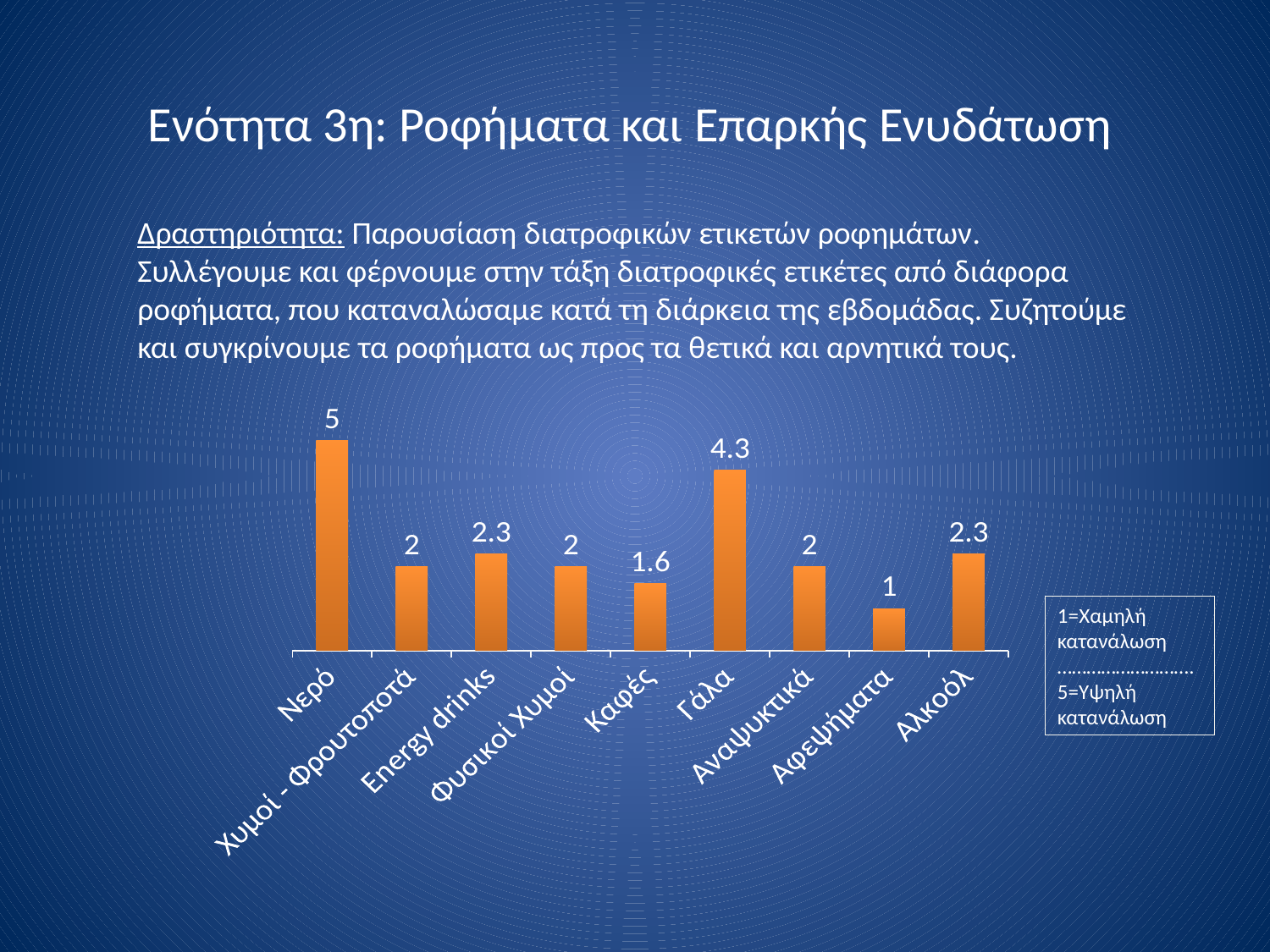
What kind of chart is shown on the slide? Bar chart What is the value for Καφές? 1.6 How many categories are shown in the chart? 9 Which is larger, the value for Αλκοόλ or the value for Αναψυκτικά? Αλκοόλ What is the value for Νερό? 5 What is the value for Αφεψήματα? 1 Which category has the lowest value? Αφεψήματα What is the value for Γάλα? 4.3 What is the difference between the values for Energy drinks and Καφές? 0.7 Which category has the highest value? Νερό What is the difference between the values for Νερό and Γάλα? 0.7 What colour are the bars in the chart? Orange